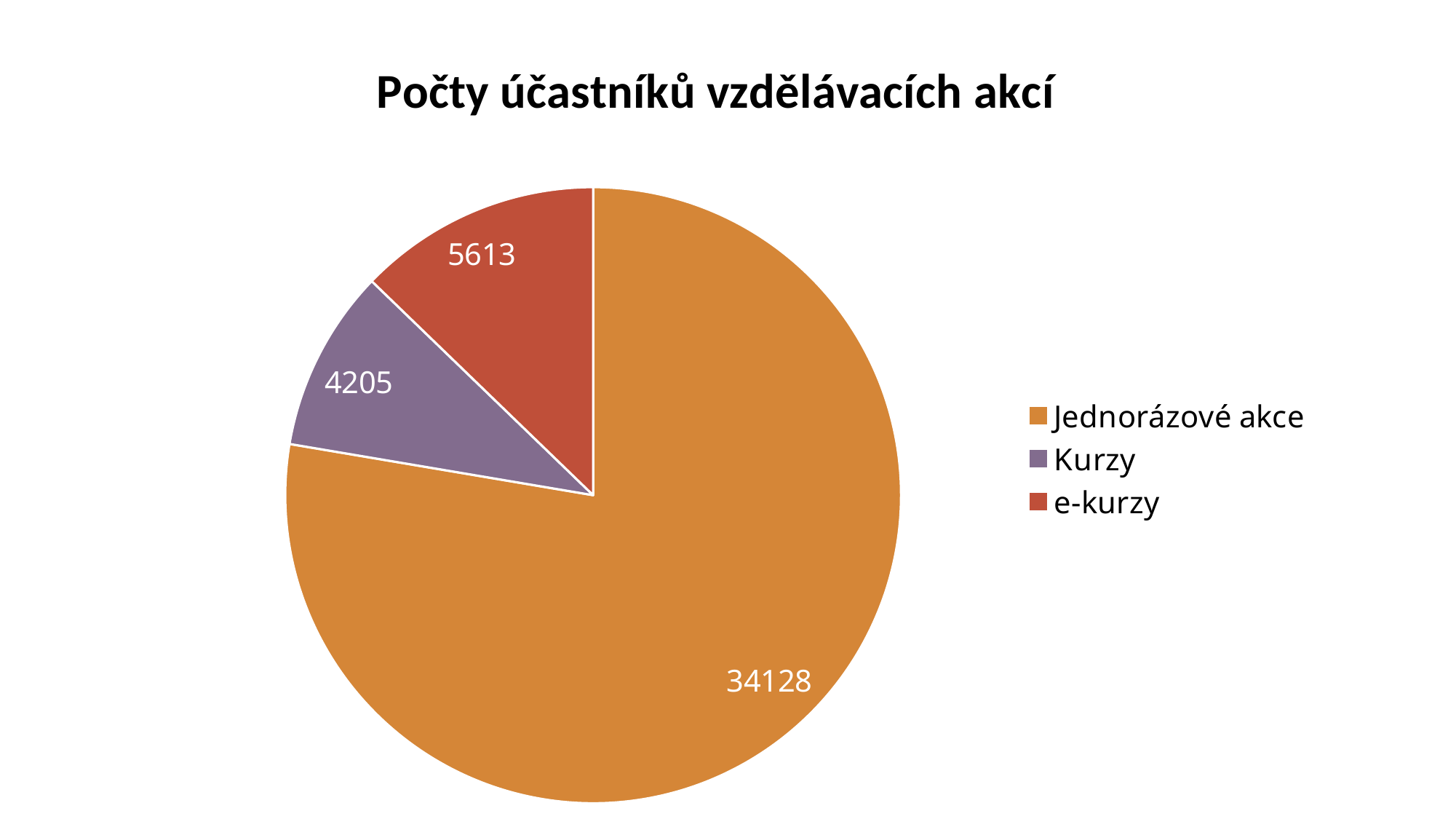
Which is larger, the value for e-kurzy or the value for Kurzy? e-kurzy What is the difference between the values for e-kurzy and Kurzy? 1408 Which category has the smallest slice? Kurzy What is the value for Jednorázové akce? 34128 What is the total of all three slices? 43946 What is the value for Kurzy? 4205 How many slices does the pie chart have? 3 What type of chart is shown on the slide? pie chart What is the value for e-kurzy? 5613 How many entries does the legend list? 3 Which category has the largest slice? Jednorázové akce What is the title of the chart? Počty účastníků vzdělávacích akcí